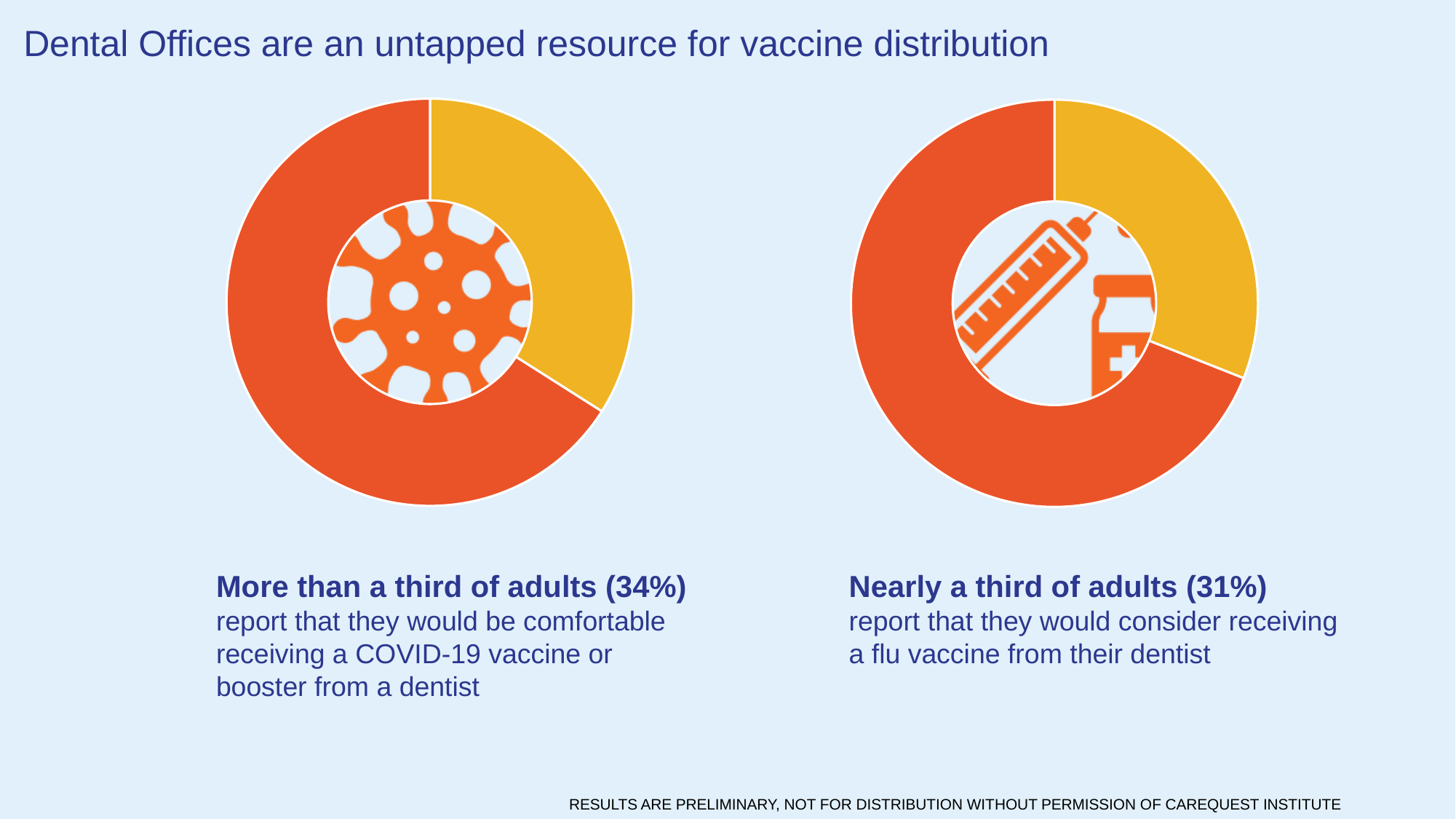
In the left chart (COVID-19 vaccine), what share of adults report they would be comfortable receiving a COVID-19 vaccine or booster from a dentist? 34% In the right chart, is the orange slice greater or less than 50% of the donut? greater In the left chart, is the yellow slice greater or less than 50% of the donut? less In the right chart (flu vaccine), what share of adults report they would consider receiving a flu vaccine from their dentist? 31% What kind of charts are shown on the slide? Donut (pie) charts What is the title of the slide? Dental Offices are an untapped resource for vaccine distribution How many slices does each donut chart have? 2 How many charts are on the slide? 2 What is the difference in percentage points between the COVID-19 vaccine share (left chart) and the flu vaccine share (right chart)? 3 percentage points What colour is the slice representing the 34% of adults in the left chart? Yellow Which is larger: the share of adults comfortable receiving a COVID-19 vaccine from a dentist (left chart) or the share who would consider a flu vaccine from their dentist (right chart)? COVID-19 vaccine (34%)